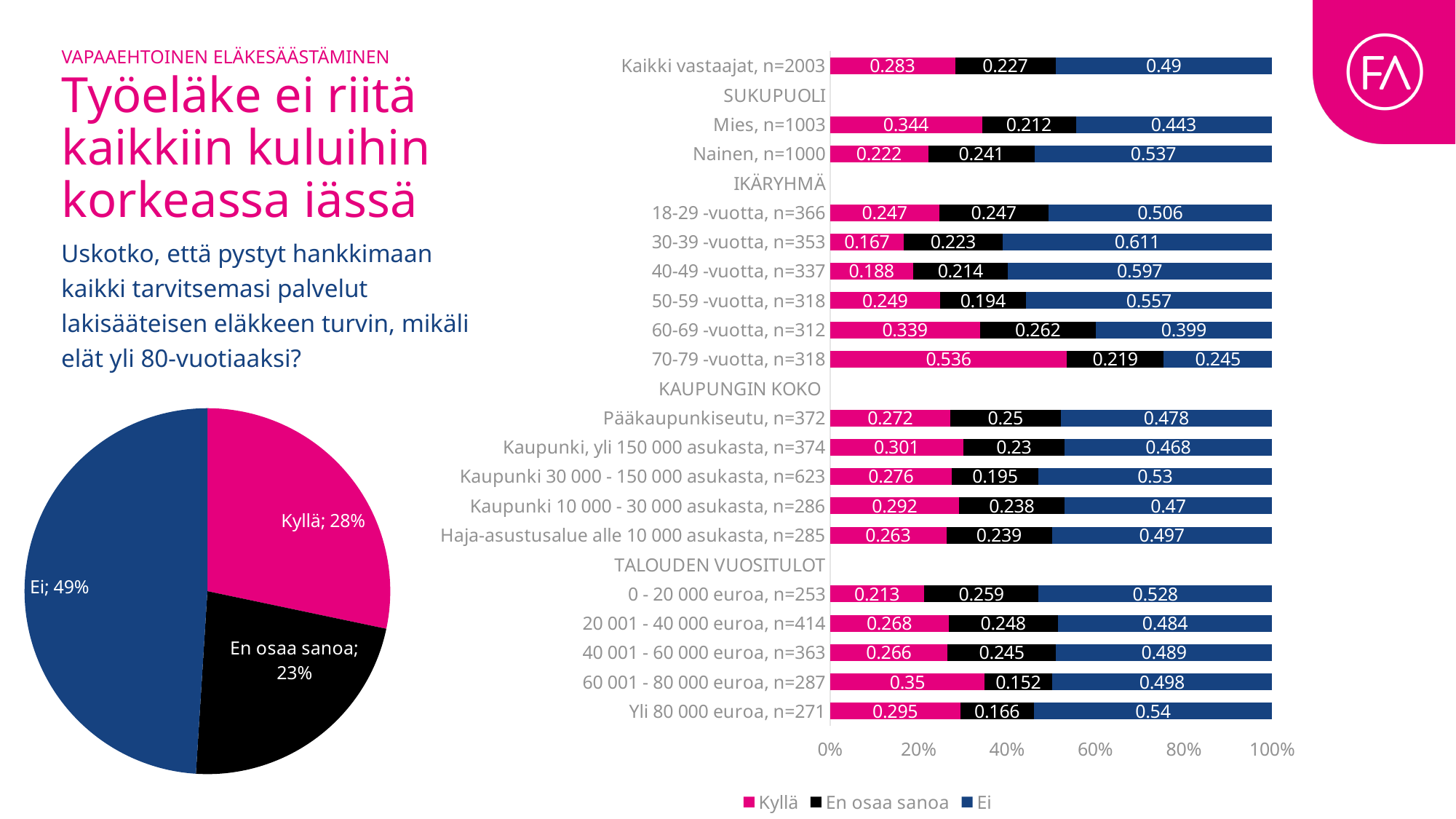
In the pie chart on the left, what share of respondents answered "Kyllä"? 28% In the pie chart on the left, which slice is the smallest? En osaa sanoa In the stacked bar chart on the right, which is larger: the "Ei" value for "Mies, n=1003" or for "Nainen, n=1000"? Nainen, n=1000 In the pie chart on the left, which slice is the largest? Ei In the stacked bar chart on the right, what is the "Ei" value for "30-39 -vuotta, n=353"? 0.611 In the stacked bar chart on the right, what is the "Kyllä" value for "Mies, n=1003"? 0.344 In the stacked bar chart on the right, what is the difference between the "Kyllä" values for "Mies, n=1003" and "Nainen, n=1000"? 0.122 In the pie chart on the left, what share of respondents answered "Ei"? 49% What kind of chart is shown on the right side of the slide? Stacked bar chart How many series does the legend of the stacked bar chart on the right list? 3 In the stacked bar chart on the right, which category has the lowest "Kyllä" value? 30-39 -vuotta, n=353 In the stacked bar chart on the right, which category has the highest "Kyllä" value? 70-79 -vuotta, n=318